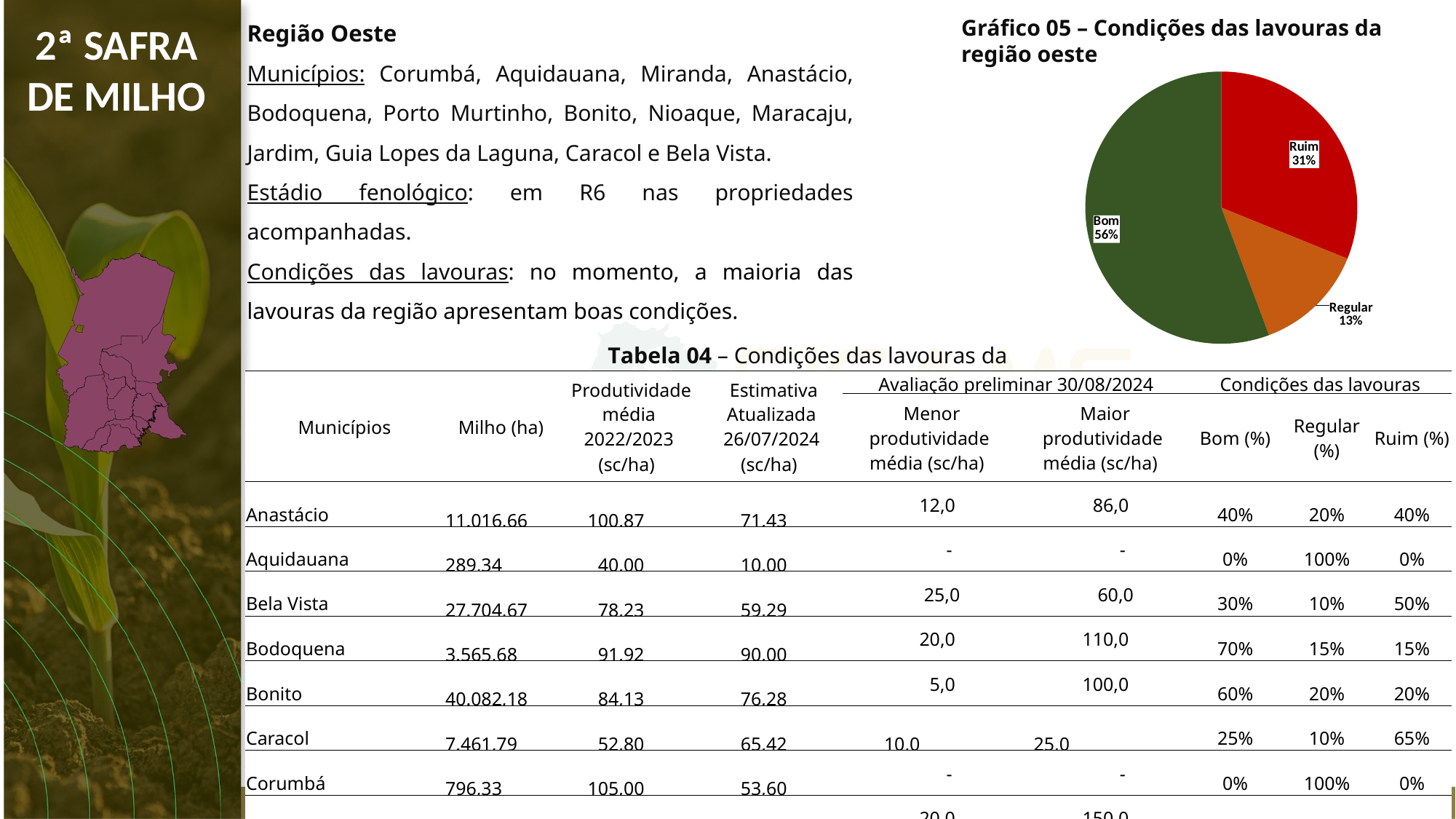
In Gráfico 05, what share of the crops is in the 'Bom' condition? 56% What is the title of the pie chart on the slide? Gráfico 05 – Condições das lavouras da região oeste In Gráfico 05, what is the difference in percentage points between the 'Ruim' and 'Regular' slices? 18 In Gráfico 05, what share of the crops is in the 'Ruim' condition? 31% In Gráfico 05, which slice is larger: 'Ruim' or 'Regular'? Ruim Which condition category has the smallest slice in Gráfico 05? Regular In Gráfico 05, what is the difference in percentage points between the 'Bom' and 'Ruim' slices? 25 In Gráfico 05, what colour is the 'Bom' slice? green What kind of chart is Gráfico 05? pie chart In Gráfico 05, what share of the crops is in the 'Regular' condition? 13% How many slices does the pie chart in Gráfico 05 have? 3 Which condition category has the largest slice in Gráfico 05? Bom